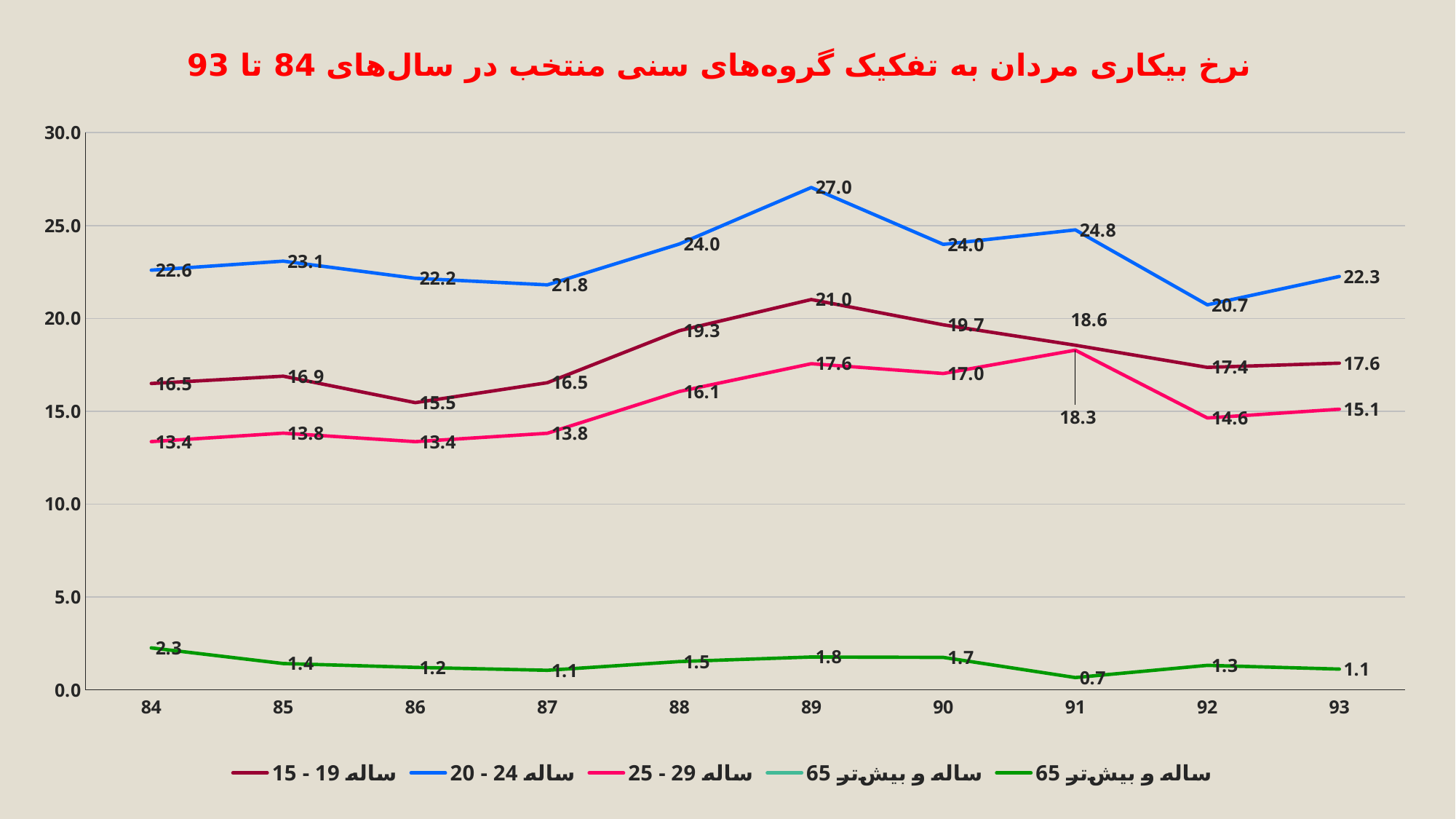
What is the difference between the 20 - 24 ساله value and the 15 - 19 ساله value in year 89? 6.0 Which is larger in year 91: the 15 - 19 ساله value or the 25 - 29 ساله value? 15 - 19 ساله In which year does the 20 - 24 ساله series have its lowest value? 92 What is the value for the 25 - 29 ساله series in year 91? 18.3 What is the value for the 65 ساله و بیش‌تر series in year 91? 0.7 What is the value for the 20 - 24 ساله series in year 89? 27.0 How many series does the legend list? 5 In which year does the 20 - 24 ساله series reach its highest value? 89 How many years are shown on the x axis? 10 What type of chart is shown on the slide? line chart What is the value for the 15 - 19 ساله series in year 86? 15.5 Does the 25 - 29 ساله series rise or fall from year 91 to year 92? fall